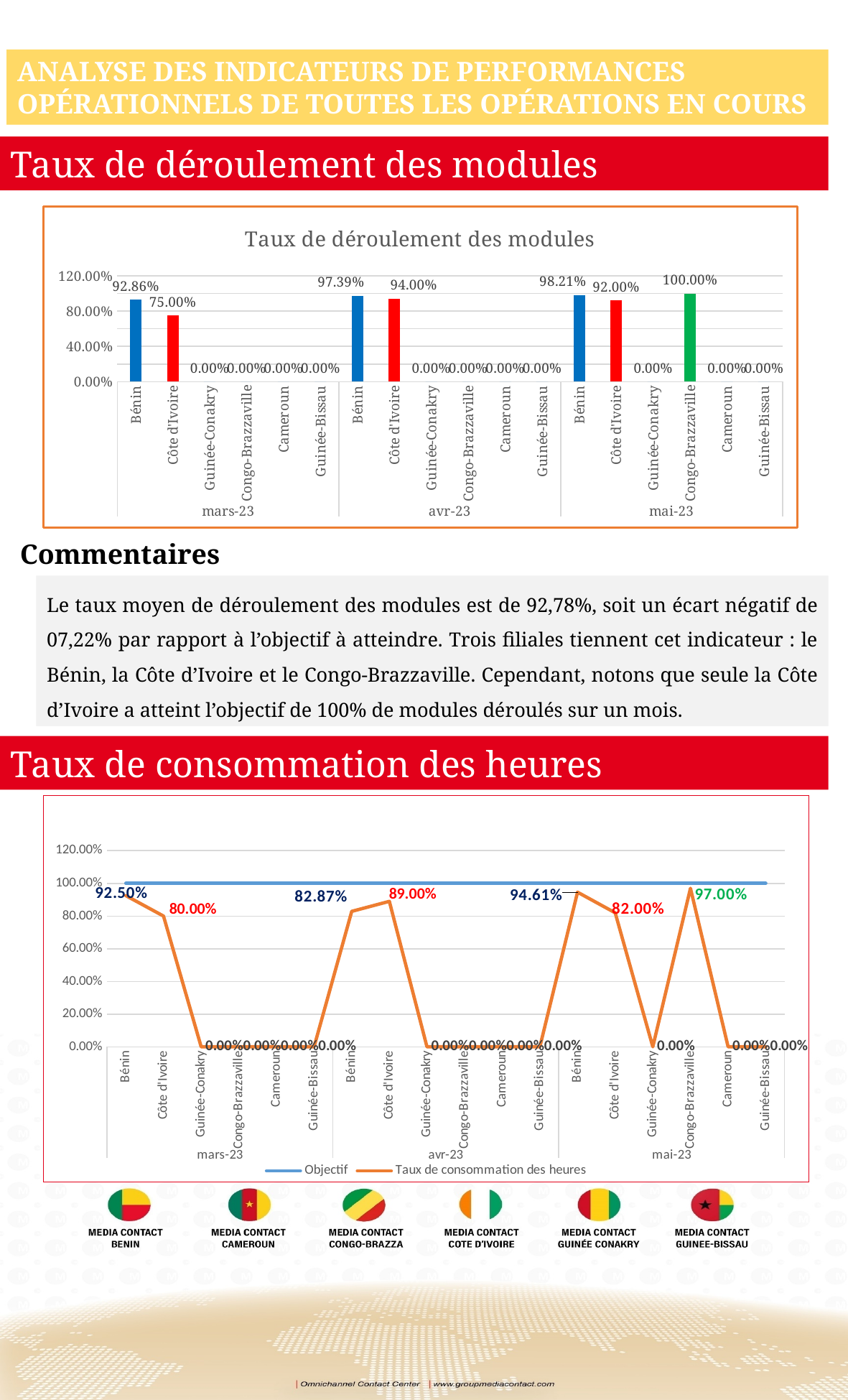
In the 'Taux de consommation des heures' chart at the bottom, what is the value for Congo-Brazzaville in mai-23? 97.00% In the 'Taux de déroulement des modules' chart, how many months are shown on the x axis? 3 In the 'Taux de déroulement des modules' chart, what is the value for Côte d'Ivoire in avr-23? 94.00% In the 'Taux de consommation des heures' chart at the bottom, what is the value for Bénin in avr-23? 82.87% In the 'Taux de consommation des heures' chart at the bottom, how many series does the legend list? 2 In the 'Taux de déroulement des modules' chart, what is the value for Bénin in mars-23? 92.86% In the 'Taux de déroulement des modules' chart, which category has the highest value in mai-23? Congo-Brazzaville What kind of chart is the 'Taux de déroulement des modules' chart? Bar chart In the 'Taux de déroulement des modules' chart, which is larger in mai-23: Bénin or Côte d'Ivoire? Bénin In the 'Taux de déroulement des modules' chart, what is the difference between Bénin and Côte d'Ivoire in mars-23? 17.86% In the 'Taux de consommation des heures' chart at the bottom, what is the difference between Bénin and Côte d'Ivoire in mai-23? 12.61% In the 'Taux de consommation des heures' chart at the bottom, which is larger in avr-23: Bénin or Côte d'Ivoire? Côte d'Ivoire